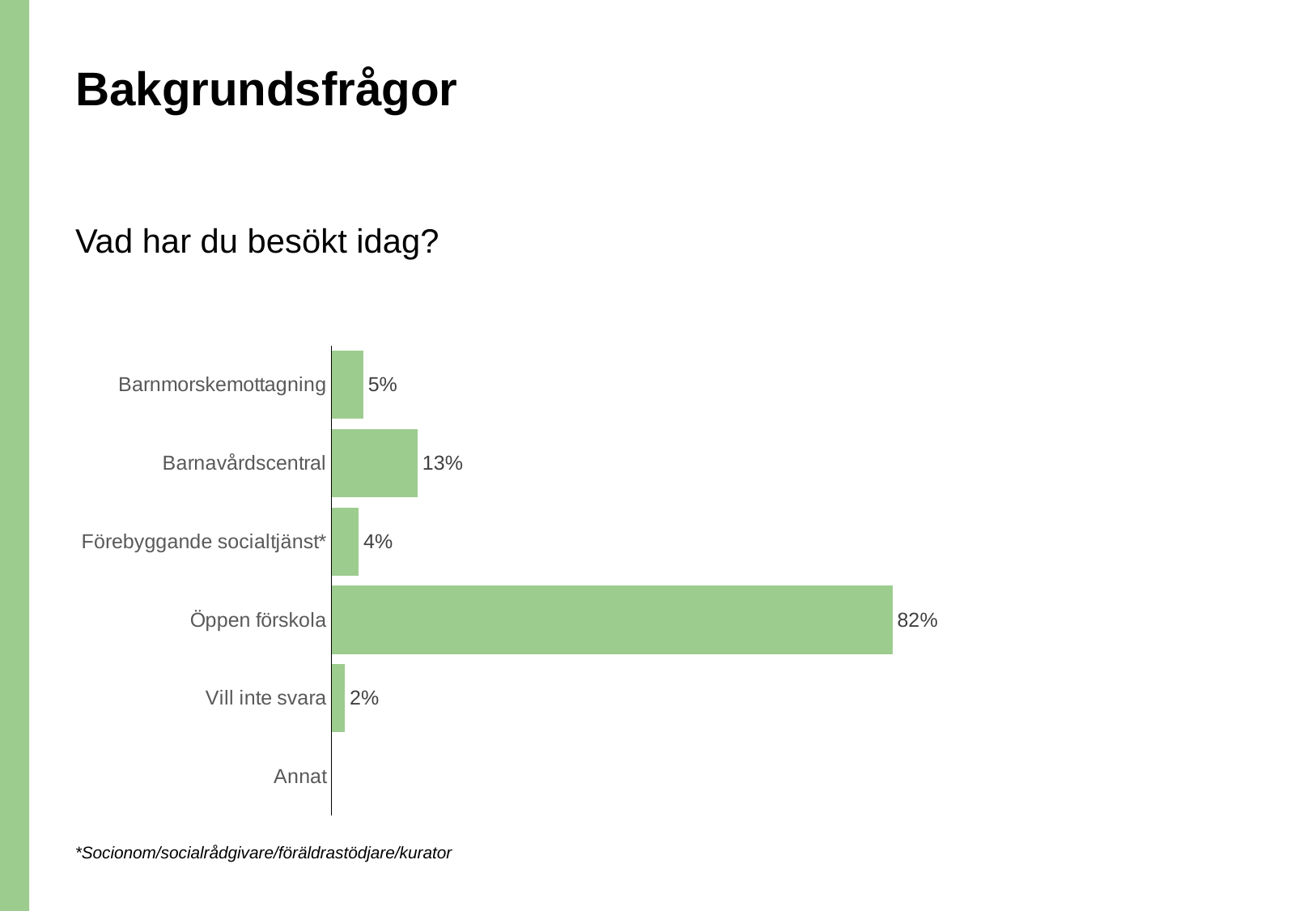
What is the difference between the values for Barnmorskemottagning and Förebyggande socialtjänst*? 1% What is the value shown for Barnavårdscentral? 13% What percentage of respondents visited Öppen förskola? 82% What kind of chart is shown on the slide? Bar chart Which category on the chart has no bar or value label shown? Annat Which is larger, the value for Barnavårdscentral or the value for Barnmorskemottagning? Barnavårdscentral What is the value shown for Barnmorskemottagning? 5% Which category has the highest value in the chart? Öppen förskola What is the value shown for Förebyggande socialtjänst*? 4% What is the difference between the values for Öppen förskola and Barnavårdscentral? 69% What is the value shown for Vill inte svara? 2% How many categories are listed on the chart's axis? 6